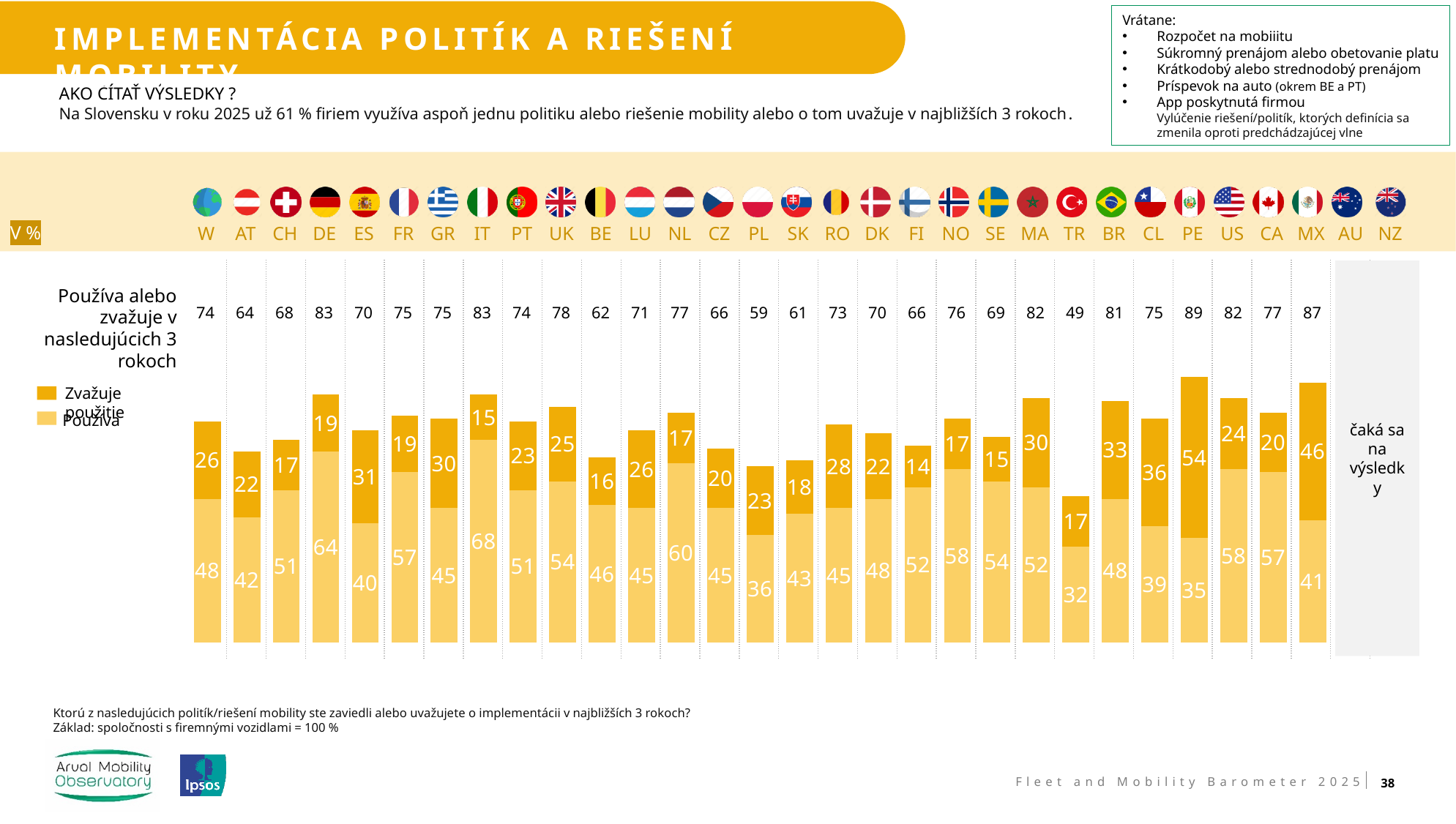
What kind of chart is shown on the slide? Stacked bar chart Which country has the lowest 'Zvažuje použitie' value? FI What is the difference between the total values for MX and W? 13 Which country has the lowest total value? TR How many series does the legend list? 2 What is the 'Zvažuje použitie' value for PE? 54 What is shown for AU and NZ instead of bars? čaká sa na výsledky Which country has the highest 'Používa' value? IT Which country has the highest total value? PE What is the 'Používa' value for DE? 64 What is the total value (uses or considers in the next 3 years) for SK? 61 Which has a larger 'Používa' value, NL or UK? NL